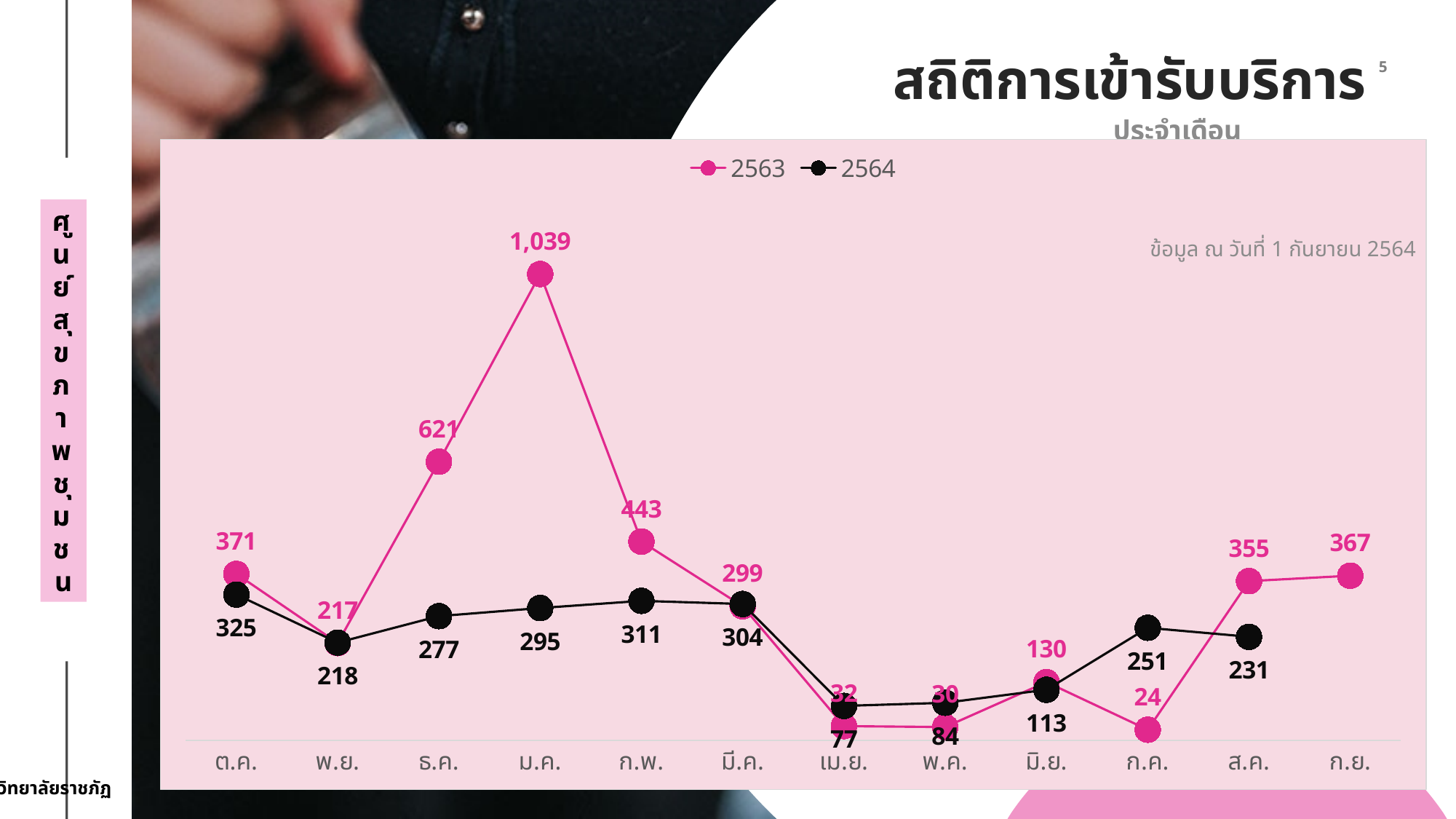
What type of chart is shown on the slide? line chart Which month has the lowest value in the 2564 series? เม.ย. How many months are shown on the x axis? 12 What is the difference between the 2563 and 2564 values for ธ.ค.? 344 Which month has the highest value in the 2563 series? ม.ค. Does the 2563 series rise or fall from ธ.ค. to ม.ค.? rise How many series does the legend list? 2 What colour is the line for the 2564 series? black What is the value for ก.ค. in the 2563 series? 24 What is the value for ม.ค. in the 2563 series? 1,039 Which series has the larger value for ก.ค., 2563 or 2564? 2564 What is the value for ธ.ค. in the 2564 series? 277